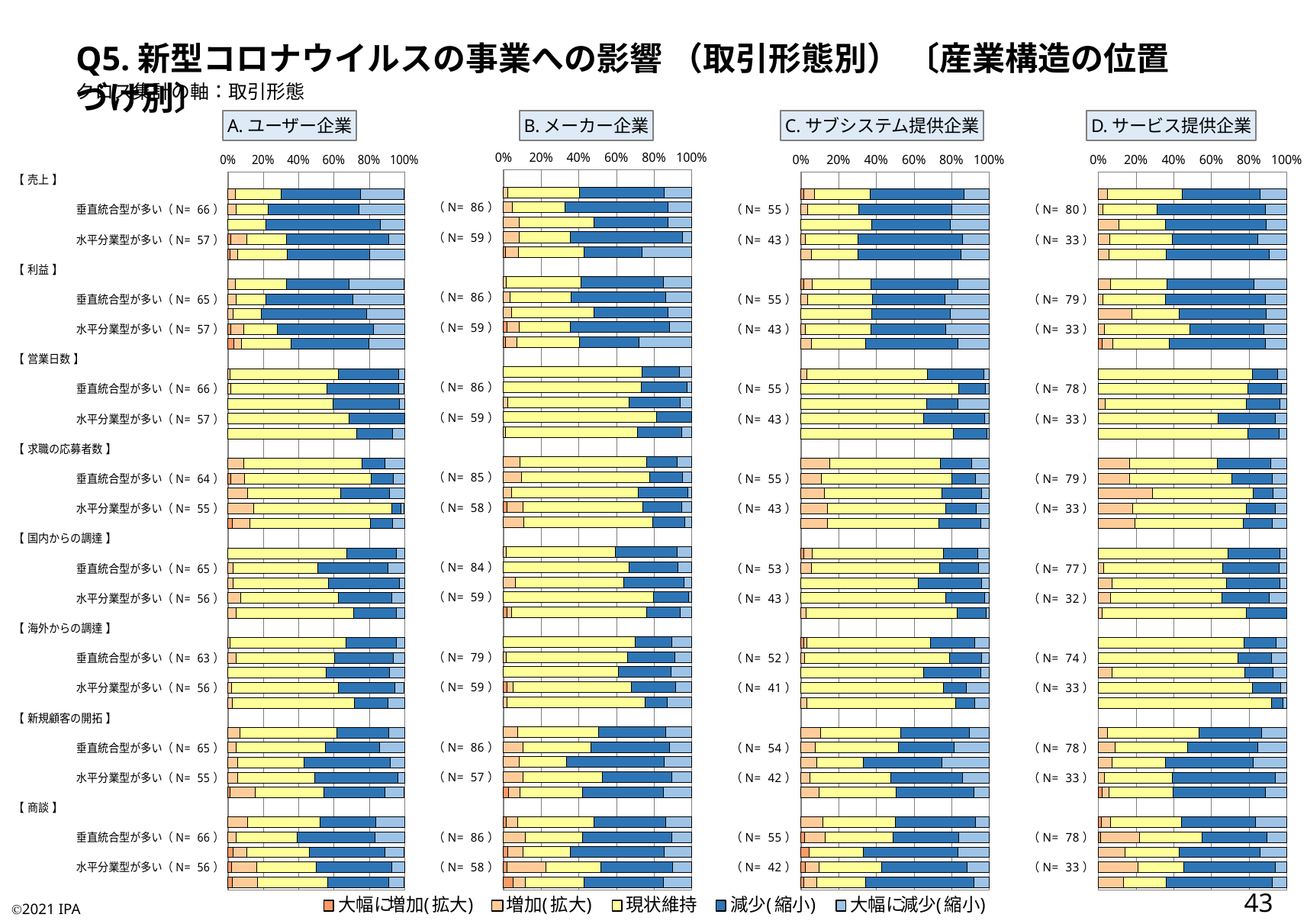
In chart B. メーカー企業, what is the N value shown for 垂直統合型が多い under 【売上】? 86 In chart D. サービス提供企業, is the right edge of the 現状維持 segment for 水平分業型が多い under 【海外からの調達】 greater or less than 60%? greater In chart D. サービス提供企業, what is the N value shown for 垂直統合型が多い under 【営業日数】? 78 What kind of chart is used for the four panels on this slide? bar chart In chart A. ユーザー企業, is the right edge of the 現状維持 segment for 垂直統合型が多い under 【営業日数】 greater or less than 40%? greater What are the titles of the four chart panels on the slide, from left to right? A. ユーザー企業, B. メーカー企業, C. サブシステム提供企業, D. サービス提供企業 How many item headings (such as 【売上】, 【利益】) are listed down the left side of the charts? 8 In chart C. サブシステム提供企業, what is the N value shown for 水平分業型が多い under 【利益】? 43 What are the five legend entries shown at the bottom of the slide? 大幅に増加(拡大), 増加(拡大), 現状維持, 減少(縮小), 大幅に減少(縮小) In chart A. ユーザー企業, what is the N value shown for 垂直統合型が多い under 【売上】? 66 How many series does the legend at the bottom of the slide list? 5 What is the maximum value shown on the horizontal axis of each chart? 100%